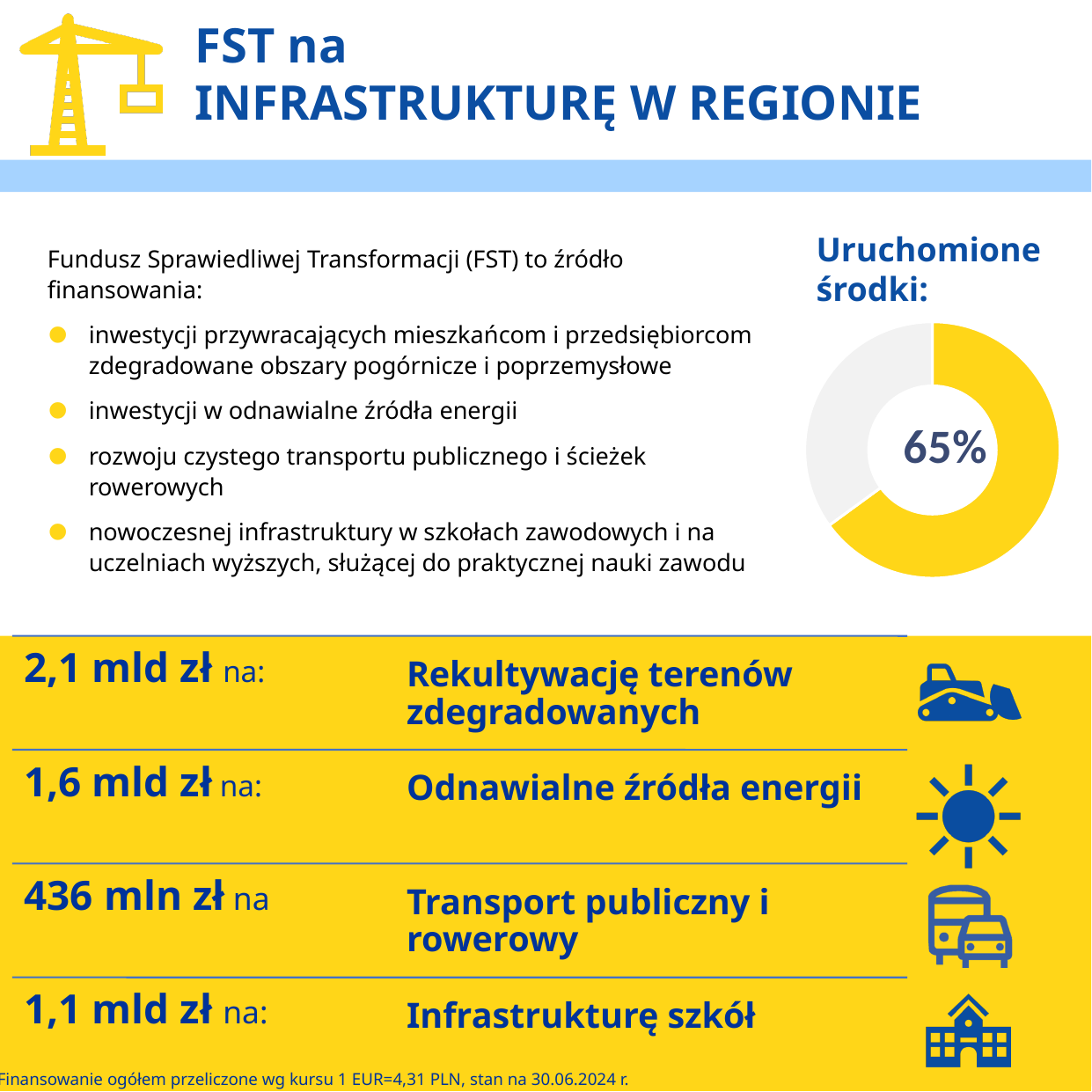
What is the title above the donut chart on the slide? Uruchomione środki: What colour is the larger slice of the donut chart? yellow Is the share shown in the donut chart greater or less than 50%? greater How many slices does the donut chart have? 2 What kind of chart is shown under the heading "Uruchomione środki"? donut (pie) chart What percentage is shown in the centre of the donut chart titled "Uruchomione środki"? 65% Which slice of the donut chart is larger, the yellow one or the grey one? yellow What share of the donut chart does the yellow slice represent? 65%